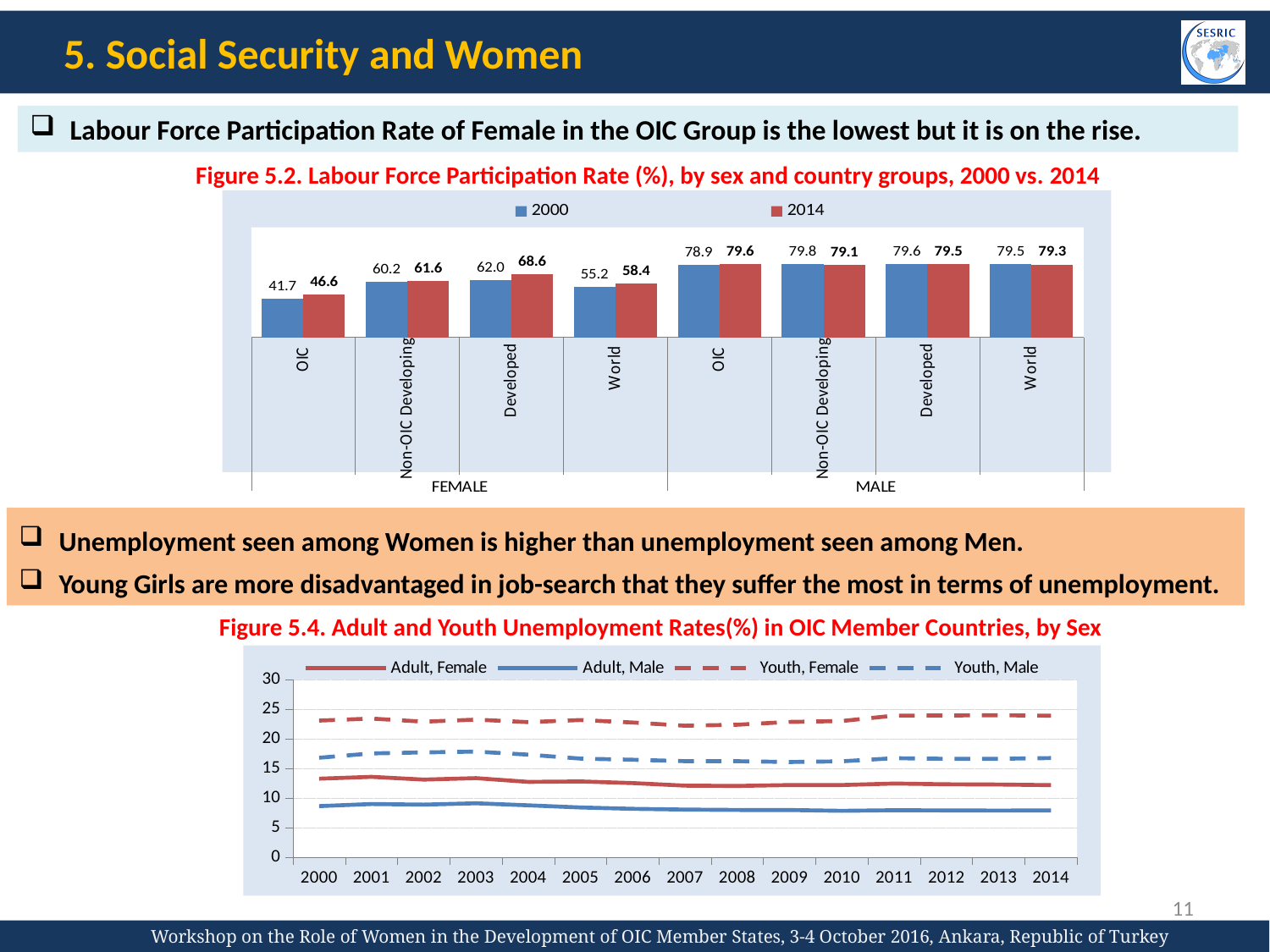
In Figure 5.2, what is the male labour force participation rate for Non-OIC Developing countries in 2000? 79.8 In Figure 5.2, how many series does the legend list? 2 In Figure 5.4, how many series does the legend list? 4 In Figure 5.4, does the Adult, Male unemployment rate rise or fall from 2000 to 2014? fall In Figure 5.4, is the Youth, Female unemployment rate in 2014 greater or less than 20? greater In Figure 5.2, by how much did the female participation rate for the OIC group increase from 2000 to 2014? 4.9 In Figure 5.4, how many years are shown on the x axis? 15 In Figure 5.2, what is the female labour force participation rate for the OIC group in 2014? 46.6 In Figure 5.2, is the female participation rate for Developed countries higher in 2000 or in 2014? 2014 In Figure 5.2, which female country group has the lowest participation rate in 2000? OIC In Figure 5.2, which female country group has the highest participation rate in 2014? Developed What type of chart is Figure 5.2? Bar chart